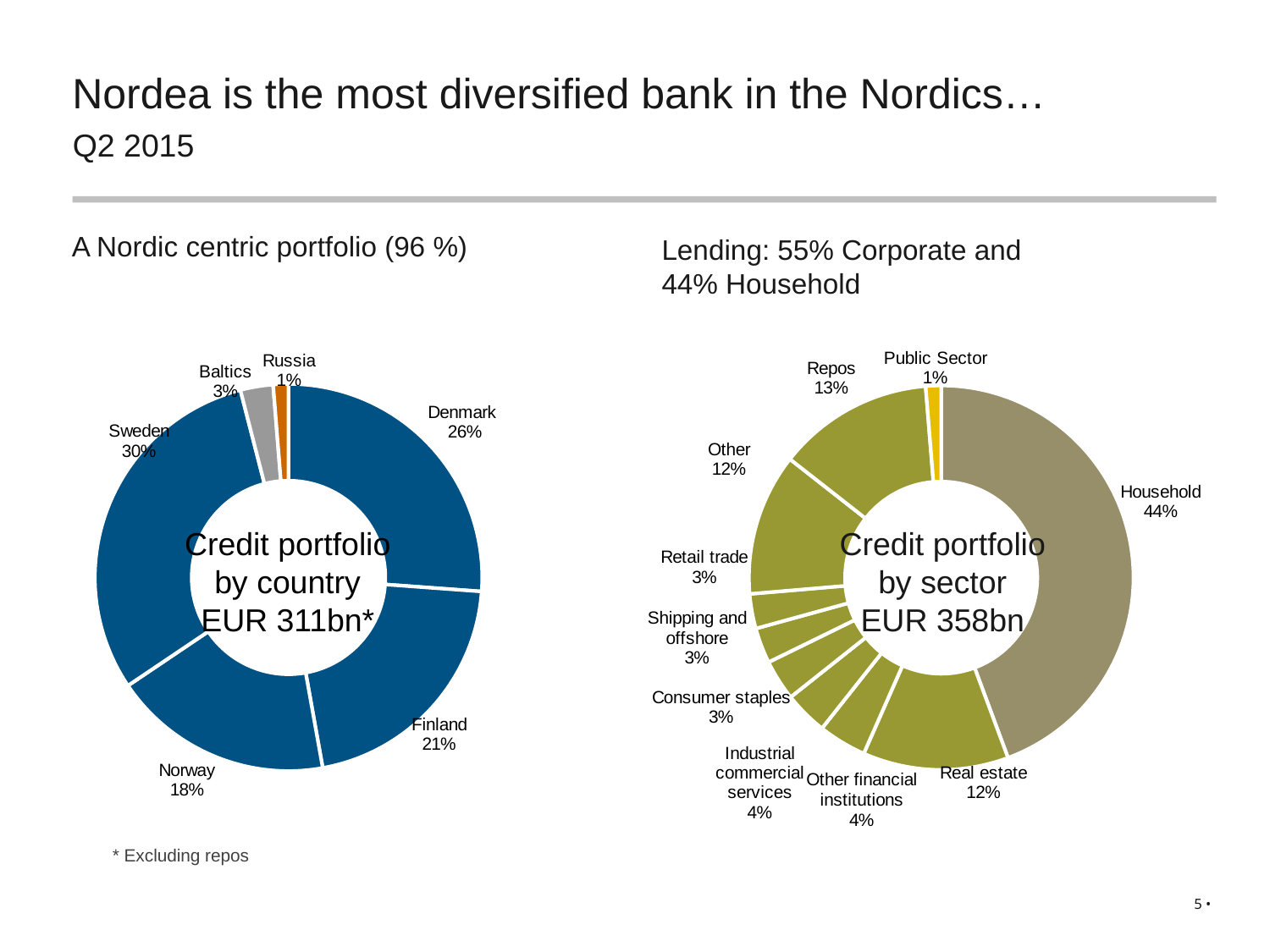
What type of chart is used for the 'Credit portfolio by sector' chart? Doughnut (pie) chart In the 'Credit portfolio by country' chart, what is the difference in percentage points between Denmark and Norway? 8 percentage points In the 'Credit portfolio by sector' chart, how many categories are shown? 10 In the 'Credit portfolio by country' chart, how many categories are shown? 6 In the 'Credit portfolio by sector' chart, which is larger, Real estate or Repos? Repos In the 'Credit portfolio by country' chart, which country has the largest share? Sweden In the 'Credit portfolio by sector' chart, what share does Household have? 44% In the 'Credit portfolio by country' chart, what share does Finland have? 21% In the 'Credit portfolio by sector' chart, what share does Repos have? 13% In the 'Credit portfolio by country' chart, which category has the smallest share? Russia In the 'Credit portfolio by country' chart, what share does Sweden have? 30% In the 'Credit portfolio by sector' chart, which sector has the smallest share? Public Sector